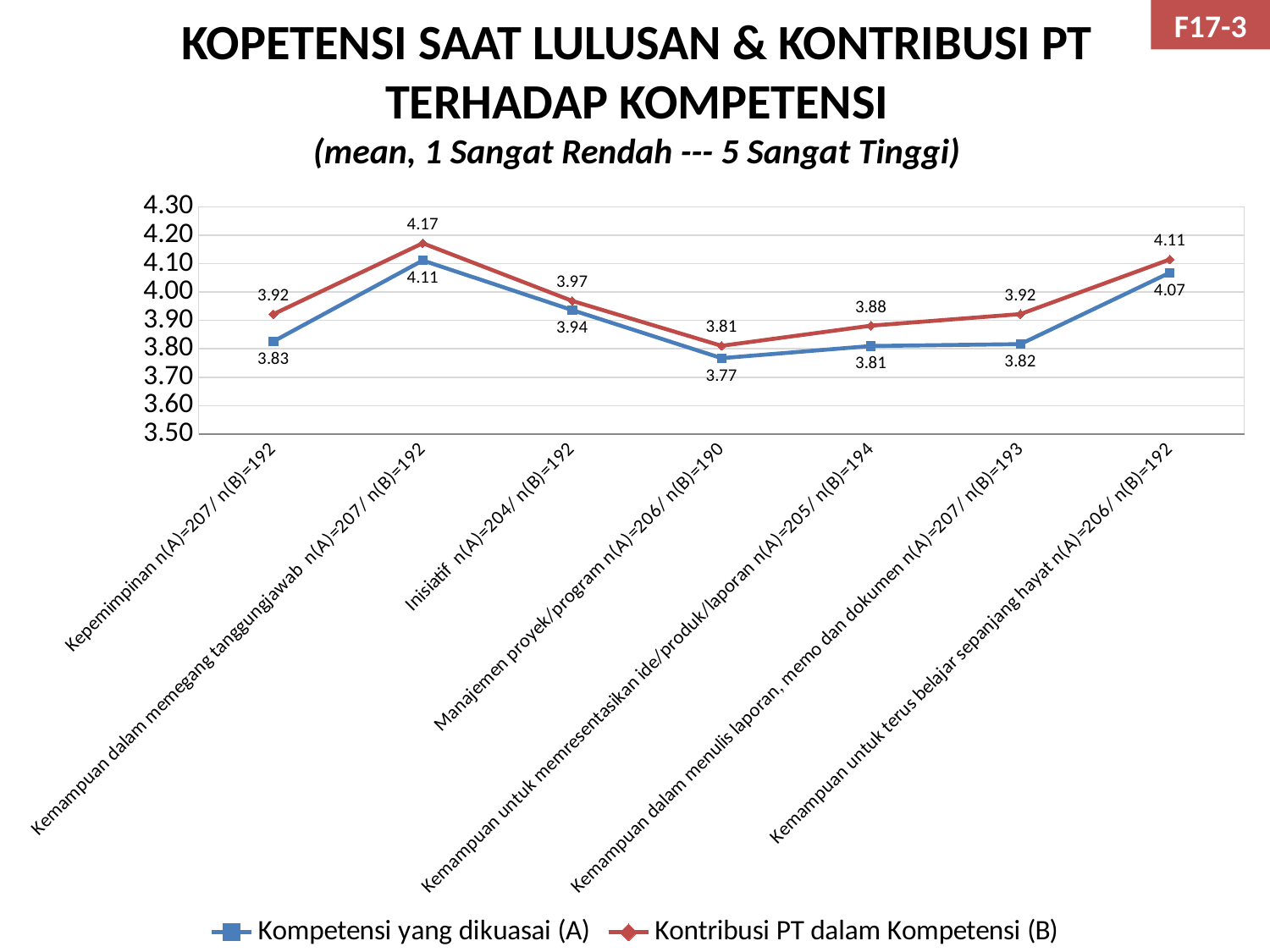
Which category has the lowest value for Kompetensi yang dikuasai (A)? Manajemen proyek/program How many categories are plotted along the x axis? 7 What is the difference between Kontribusi PT dalam Kompetensi (B) and Kompetensi yang dikuasai (A) for Kemampuan dalam menulis laporan, memo dan dokumen? 0.10 What is the value of Kontribusi PT dalam Kompetensi (B) for Inisiatif? 3.97 Which category has the highest value for Kontribusi PT dalam Kompetensi (B)? Kemampuan dalam memegang tanggungjawab What is the value of Kompetensi yang dikuasai (A) for Kepemimpinan? 3.83 How many series does the legend list? 2 What is the value of Kompetensi yang dikuasai (A) for Manajemen proyek/program? 3.77 Which colour is used for the Kontribusi PT dalam Kompetensi (B) line? Red What kind of chart is shown on the slide? Line chart Is the value of Kompetensi yang dikuasai (A) for Kemampuan dalam memegang tanggungjawab greater or less than 4.00? greater For Kemampuan untuk terus belajar sepanjang hayat, which series has the larger value, (A) or (B)? Kontribusi PT dalam Kompetensi (B)